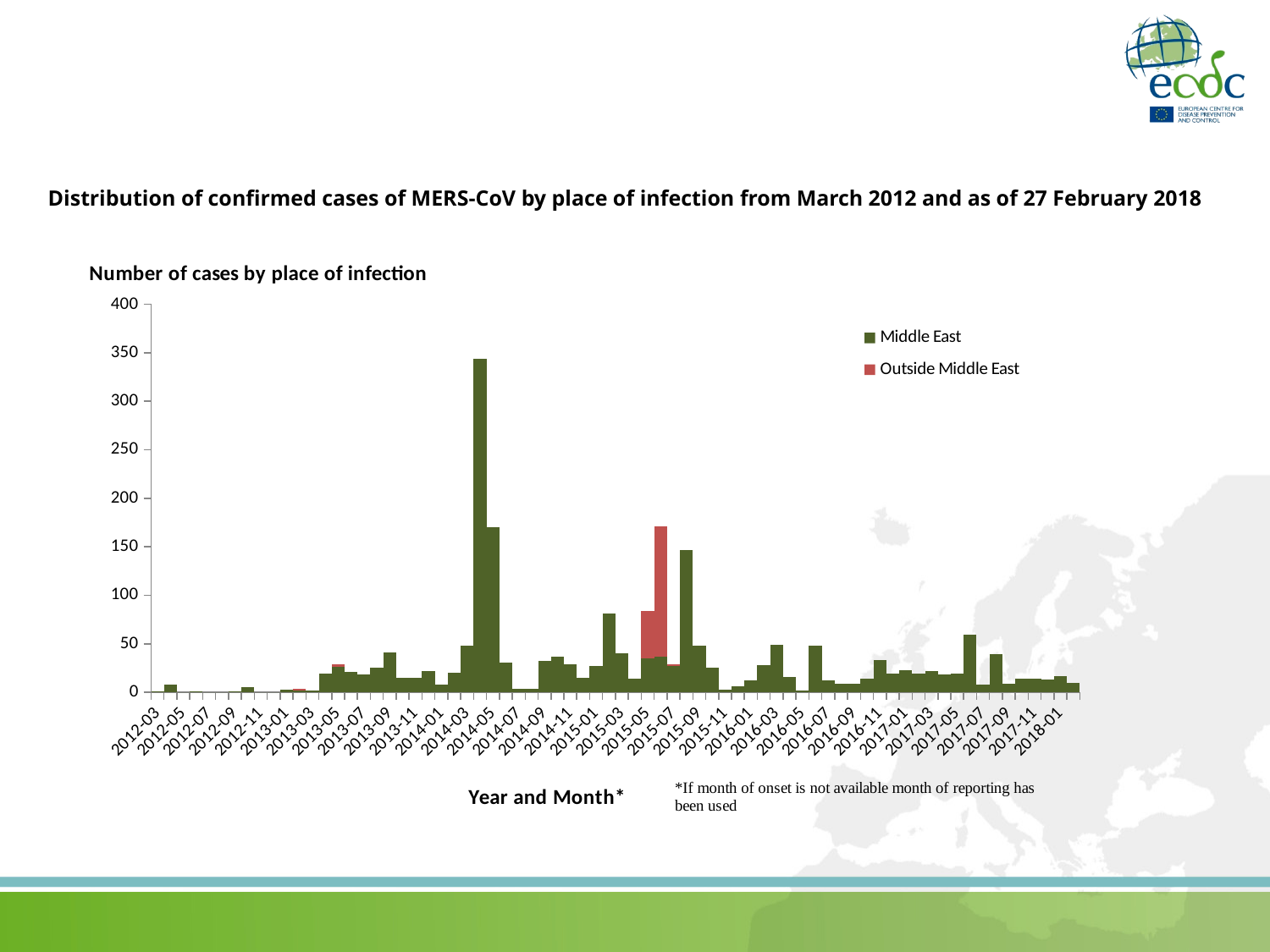
Is the value for 2012-03 greater or less than 50? less What is the highest value shown on the y axis? 400 Which series accounts for the majority of cases across the chart? Middle East Is the value for 2018-01 greater or less than 50? less How many series does the legend list? 2 Is the value for 2015-11 greater or less than 100? less What colour represents the Outside Middle East series? red What kind of chart is shown on the slide? bar chart What are the two series named in the legend? Middle East and Outside Middle East Do the values generally rise or fall from 2015-09 to 2015-11? fall